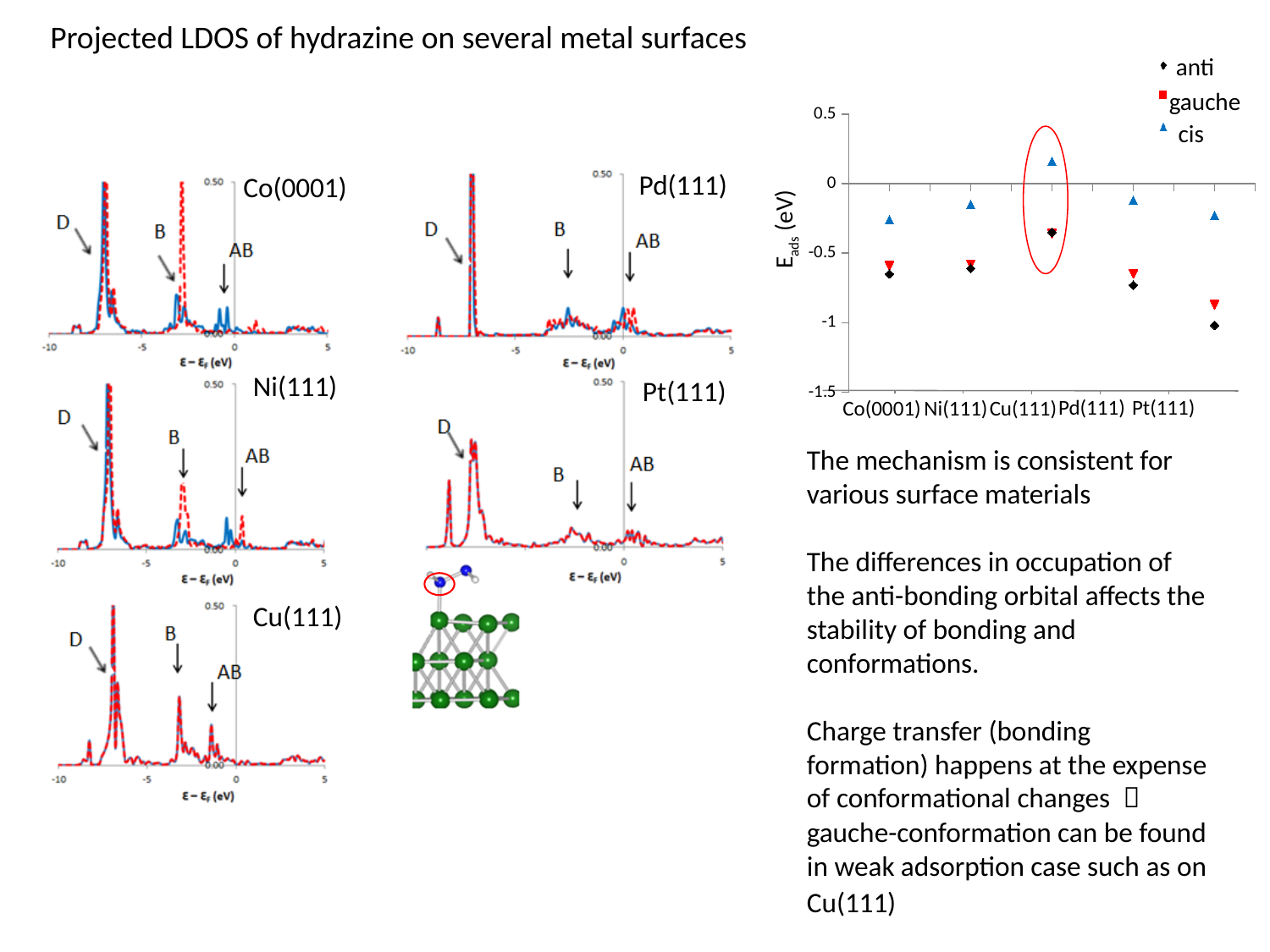
How many series does the legend of the E_ads chart list? 3 What kind of chart is the E_ads chart on the right of the slide? scatter chart In the E_ads chart, is the cis value for Pd(111) greater or less than -0.5? greater In the E_ads chart, is the gauche value for Pt(111) greater or less than -0.5? less In the E_ads chart, which surface has the larger anti value: Cu(111) or Pd(111)? Cu(111) How many metal surfaces are plotted along the x axis of the E_ads chart? 5 In the E_ads chart, which surface has the lowest anti value? Pt(111) In the E_ads chart, is the anti value for Pt(111) greater or less than -0.5? less In the E_ads chart, which surface has the highest cis value? Cu(111) In the E_ads chart, which is larger for Co(0001): the cis value or the anti value? cis In the E_ads chart, which surface's data points are circled? Cu(111)